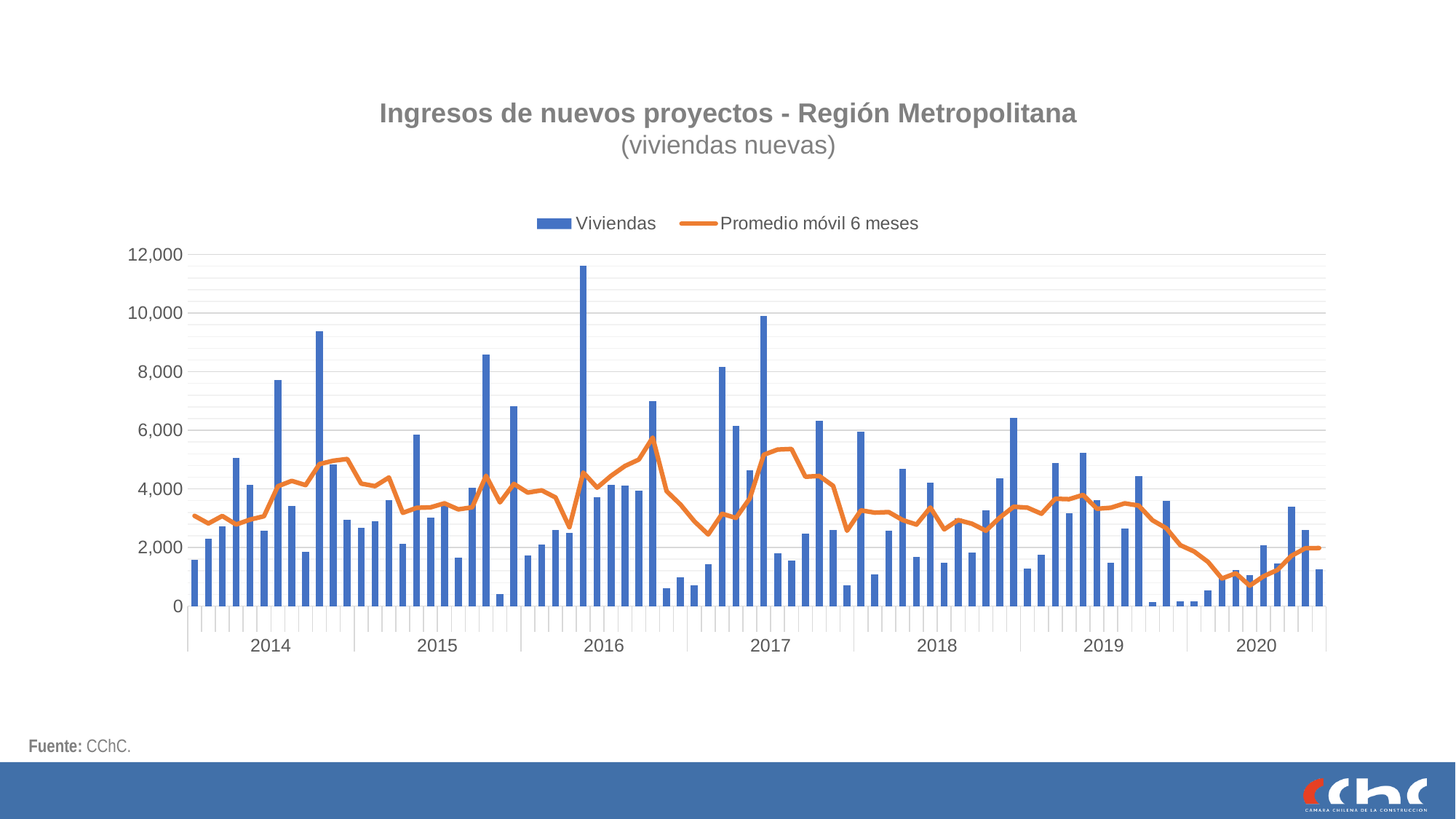
Is the tallest bar within 2020 greater or less than 4,000? less Is the tallest bar within 2017 greater or less than 8,000? greater Does the Promedio móvil 6 meses line rise or fall from the start of 2019 to the start of 2020? fall What kind of chart is shown on the slide? A bar chart combined with a line Is the tallest bar of the chart greater or less than 10,000? greater Which year contains the tallest bar: 2014 or 2020? 2014 What are the two series named in the legend? Viviendas and Promedio móvil 6 meses What is the highest value shown on the vertical axis? 12,000 How many years are labelled on the x axis? 7 How many series does the legend list? 2 In which year does the tallest bar of the whole chart occur? 2016 What is the title of the chart? Ingresos de nuevos proyectos - Región Metropolitana (viviendas nuevas)